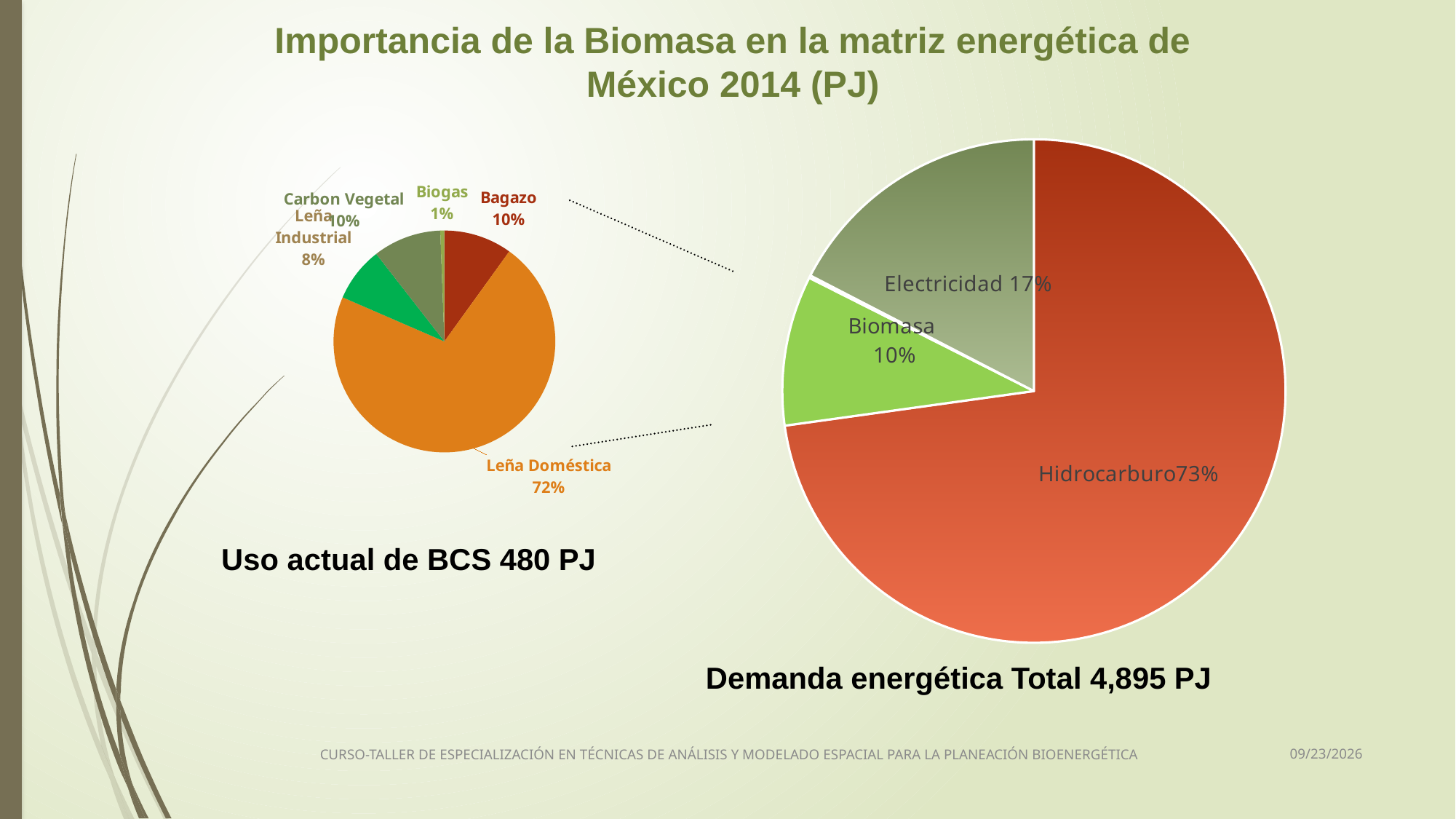
In the left-hand pie chart (Uso actual de BCS), how many slices are there? 5 In the left-hand pie chart (Uso actual de BCS), what share does Biogas have? 1% In the left-hand pie chart (Uso actual de BCS), what share does Leña Doméstica have? 72% In the right-hand pie chart (Demanda energética Total), what share does Hidrocarburo have? 73% In the left-hand pie chart (Uso actual de BCS), what is the difference in percentage points between Leña Doméstica and Bagazo? 62 What type of chart is used on the right-hand side of the slide? Pie chart In the right-hand pie chart (Demanda energética Total), which category has the largest slice? Hidrocarburo In the left-hand pie chart (Uso actual de BCS), which category has the smallest slice? Biogas